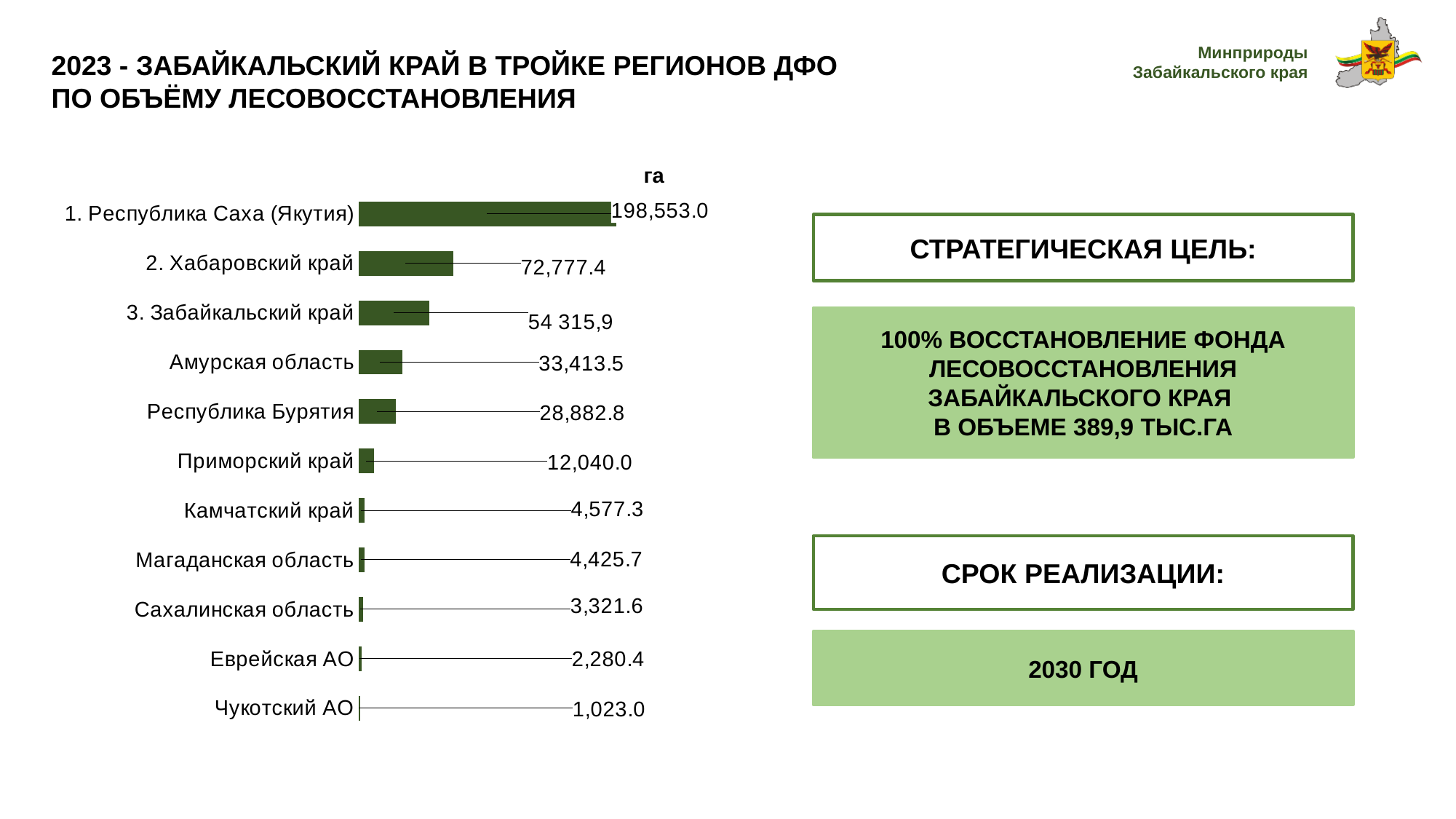
Which region has the highest value? 1. Республика Саха (Якутия) What is the difference between the values for 1. Республика Саха (Якутия) and 2. Хабаровский край? 125,775.6 What is the difference between the values for Амурская область and Республика Бурятия? 4,530.7 What is the value for 1. Республика Саха (Якутия)? 198,553.0 What kind of chart is shown on the slide? Bar chart What unit is indicated above the chart's data labels? га How many regions are shown in the chart? 11 Which region has the lowest value? Чукотский АО What is the value for Чукотский АО? 1,023.0 What is the value for 3. Забайкальский край? 54 315,9 Which has the larger value, Камчатский край or Магаданская область? Камчатский край What is the value for Республика Бурятия? 28,882.8